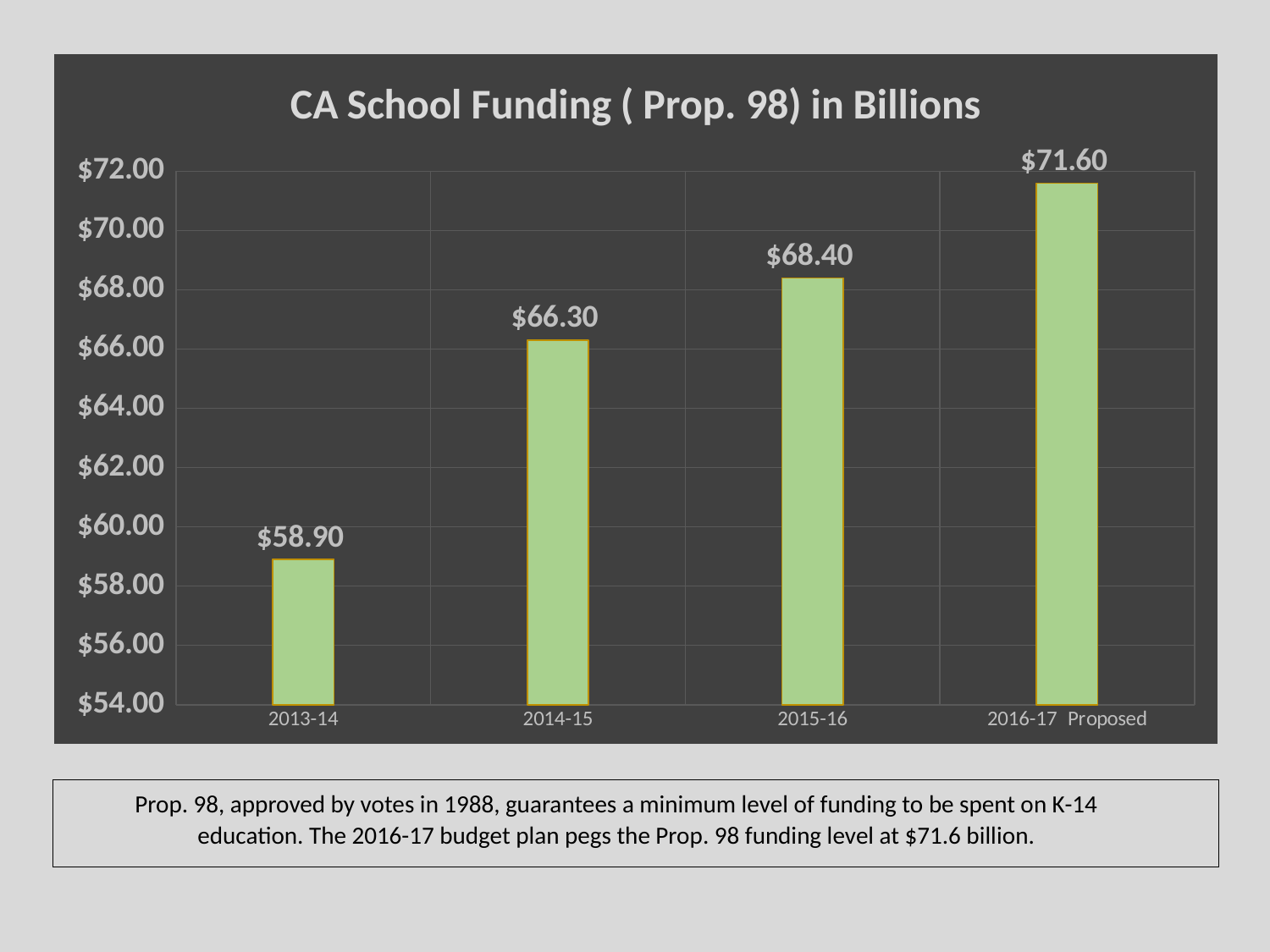
Which category has the highest value? 2016-17 Proposed Which category has the lowest value? 2013-14 How many categories are shown on the x axis? 4 Which is larger, the value for 2014-15 or the value for 2015-16? 2015-16 What is the difference between the values for 2014-15 and 2013-14? $7.40 Do the values rise or fall from 2013-14 to 2016-17 Proposed? rise Is the value for 2014-15 greater or less than $64.00? greater What is the difference between the values for 2016-17 Proposed and 2015-16? $3.20 What is the value for 2015-16? $68.40 What is the value for 2016-17 Proposed? $71.60 What is the value for 2013-14? $58.90 What kind of chart is shown? bar chart